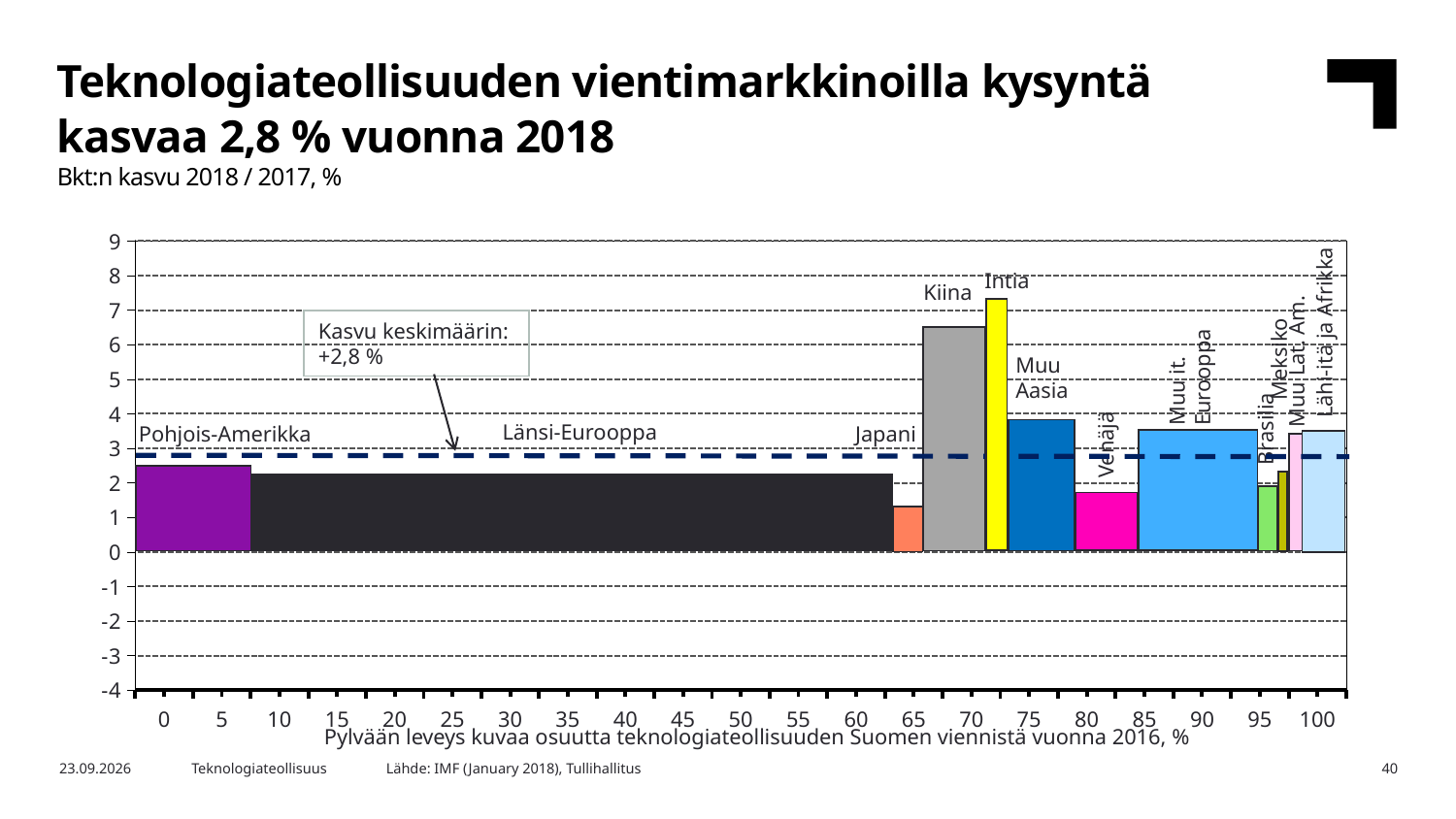
Which has the higher GDP growth, Intia or Kiina? Intia What average growth value does the dashed horizontal line represent, according to the annotation? +2,8 % Which region has the highest GDP growth in the chart? Intia Is the value for Kiina greater or less than 5? greater Which region has the lowest GDP growth in the chart? Japani Is the value for Pohjois-Amerikka greater or less than 3? less Is the value for Intia greater or less than 6? greater How many regions are shown as bars in the chart? 12 What kind of chart is shown on the slide? bar chart Which has the higher GDP growth, Kiina or Japani? Kiina